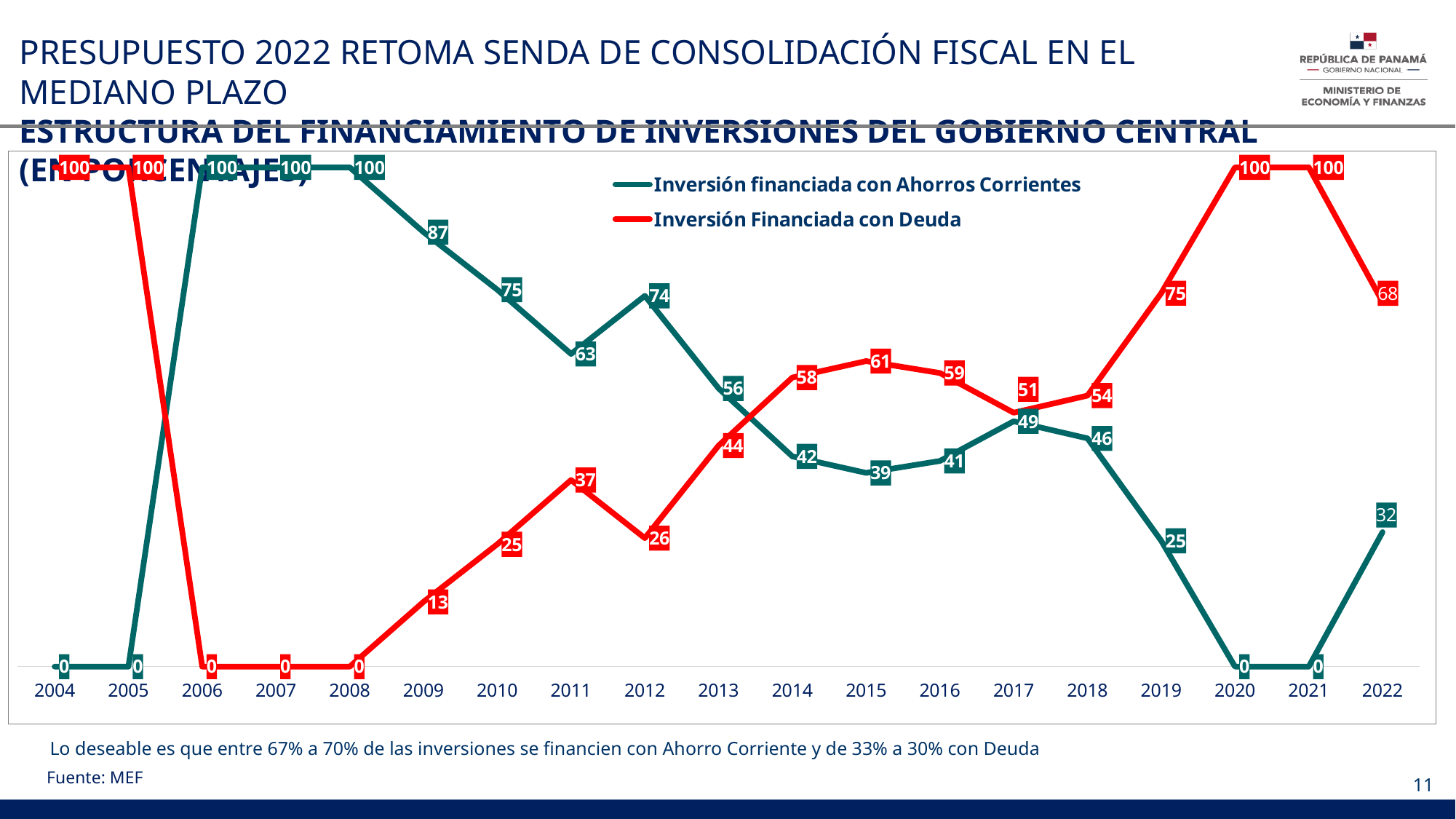
What is the value for Inversión financiada con Ahorros Corrientes in 2009? 87 What colour is the line for Inversión Financiada con Deuda? Red What is the value for Inversión financiada con Ahorros Corrientes in 2022? 32 What is the value for Inversión Financiada con Deuda in 2022? 68 In which year between 2009 and 2019 does Inversión financiada con Ahorros Corrientes reach its lowest value? 2015 What is the difference between Inversión Financiada con Deuda and Inversión financiada con Ahorros Corrientes in 2022? 36 In 2013, which series has the larger value, Inversión financiada con Ahorros Corrientes or Inversión Financiada con Deuda? Inversión financiada con Ahorros Corrientes What is the value for Inversión Financiada con Deuda in 2015? 61 Does Inversión Financiada con Deuda rise or fall from 2009 to 2011? Rise What type of chart is shown on the slide? Line chart How many series does the legend list? 2 How many years are plotted along the x axis? 19